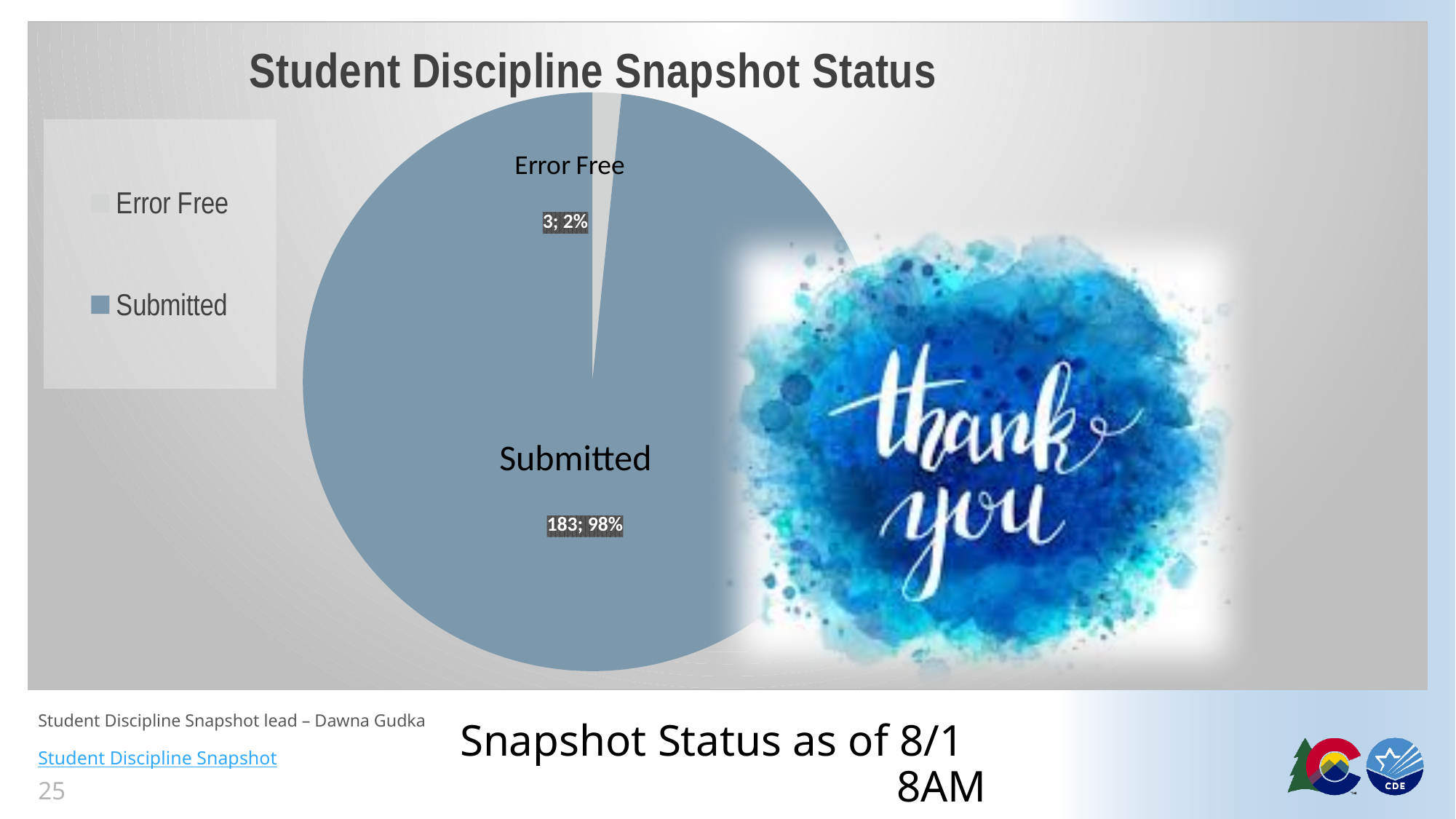
Which category has the smallest slice? Error Free What share of the pie does Submitted represent? 98% What is the total of the two slices? 186 Which category has the largest slice? Submitted How many entries does the legend list? 2 What kind of chart is shown on the slide? pie chart How many slices does the pie chart have? 2 What share of the pie does Error Free represent? 2% What is the value for Submitted? 183 What is the value for Error Free? 3 What is the difference between the Submitted and Error Free values? 180 What is the title of the chart? Student Discipline Snapshot Status